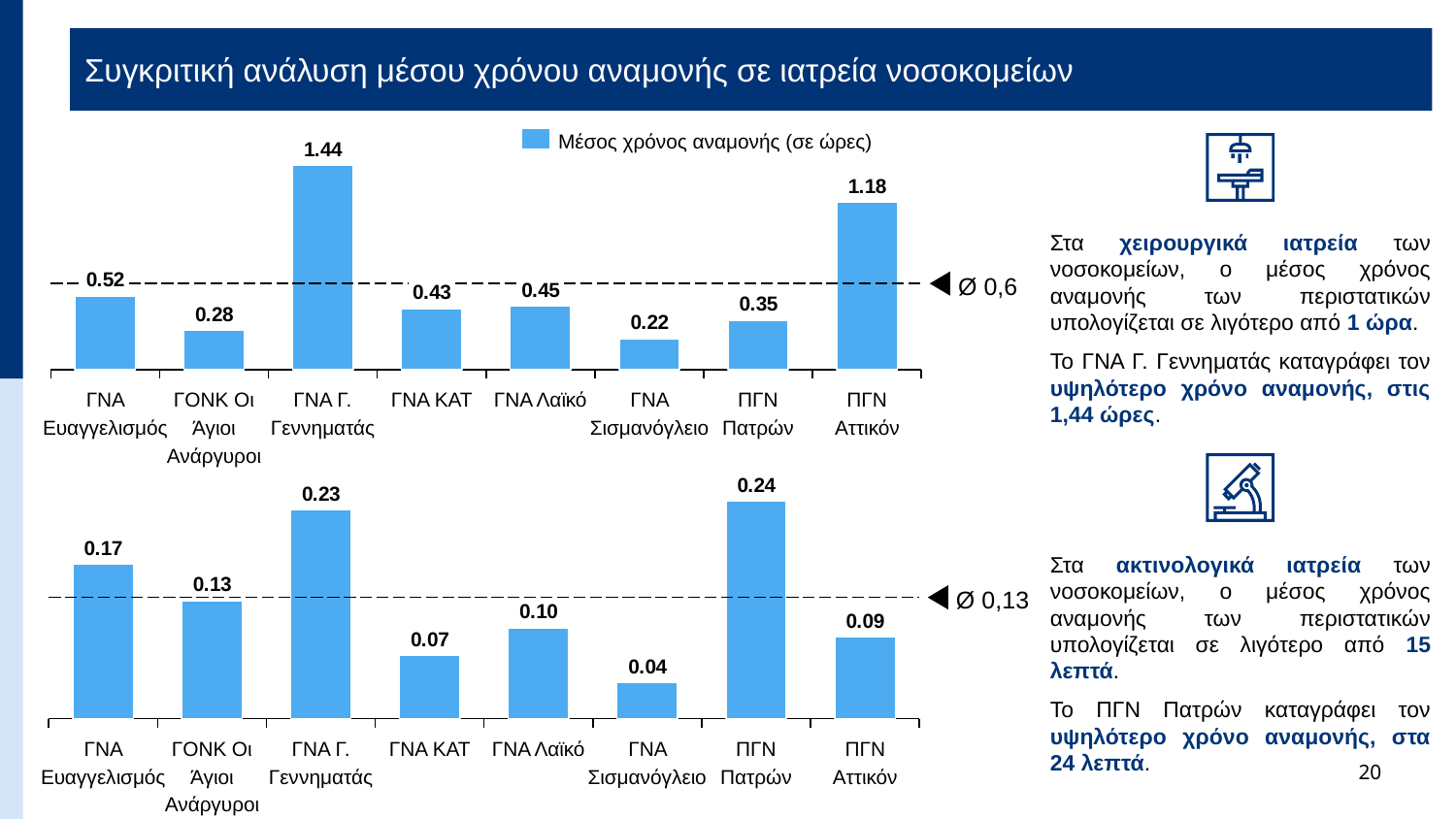
In the bottom chart, what is the value for ΠΓΝ Πατρών? 0.24 In the bottom chart, which hospital has the highest value? ΠΓΝ Πατρών In the top chart, which hospital has the lowest value? ΓΝΑ Σισμανόγλειο In the top chart, what is the value for ΓΝΑ Γ. Γεννηματάς? 1.44 In the top chart, what is the difference between ΓΝΑ Γ. Γεννηματάς and ΠΓΝ Αττικόν? 0.26 In the top chart, what is the value for ΠΓΝ Αττικόν? 1.18 In the bottom chart, what is the difference between ΓΝΑ Ευαγγελισμός and ΓΝΑ ΚΑΤ? 0.10 What average value is marked by the dashed line in the bottom chart? Ø 0,13 What kind of chart is the top chart? Bar chart In the top chart, which is larger, the value for ΓΝΑ Ευαγγελισμός or the value for ΓΟΝΚ Οι Άγιοι Ανάργυροι? ΓΝΑ Ευαγγελισμός In the top chart, how many hospitals are shown? 8 In the bottom chart, which hospital has the lowest value? ΓΝΑ Σισμανόγλειο